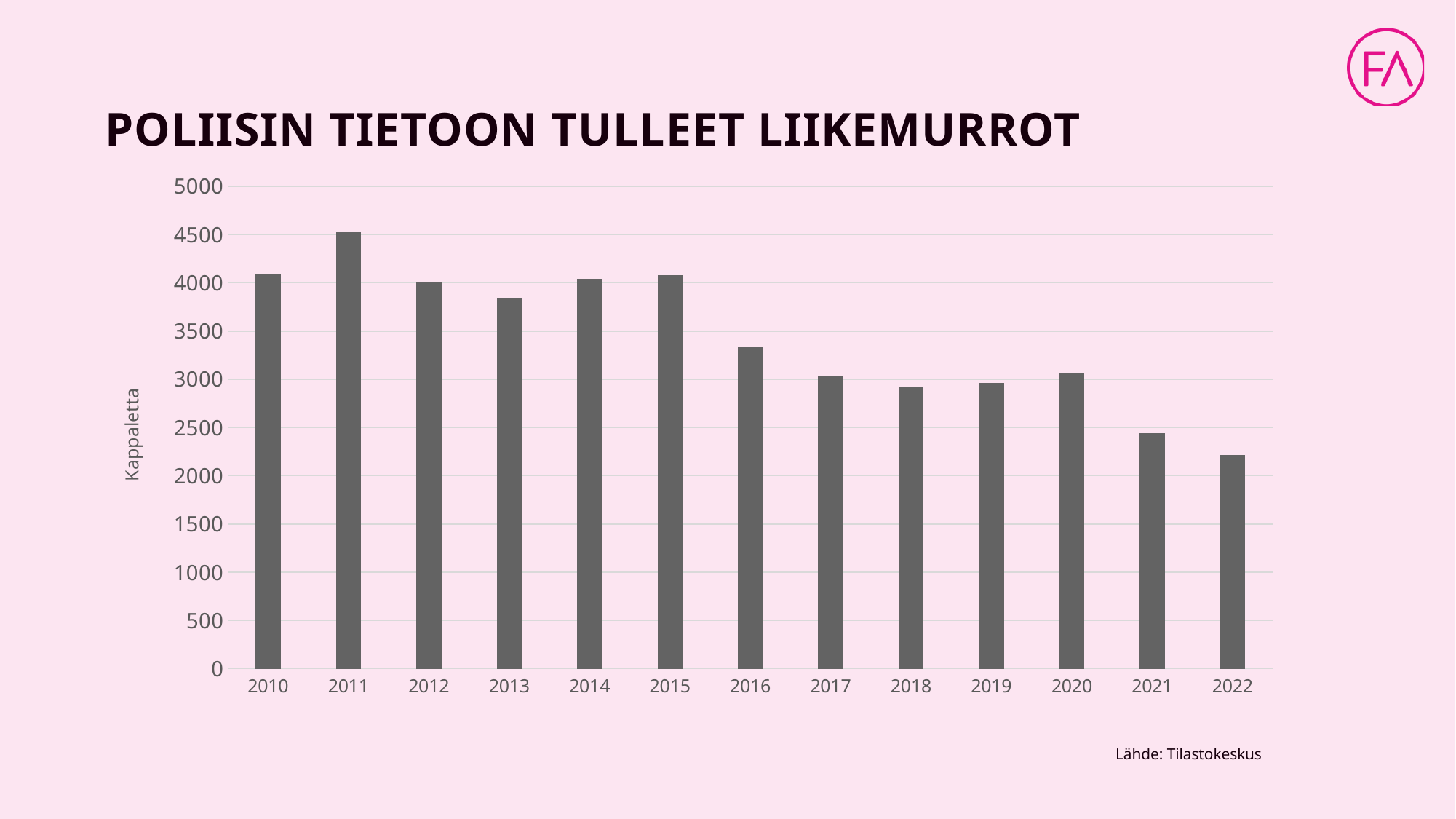
What kind of chart is shown on the slide? bar chart Is the value for 2021 greater or less than 2500? less Is the value for 2022 greater or less than 2500? less Which is larger, the value for 2011 or the value for 2022? 2011 Which is larger, the value for 2016 or the value for 2021? 2016 Which year has the lowest number of reported business burglaries? 2022 Which year has the highest number of reported business burglaries? 2011 Is the value for 2016 greater or less than 3000? greater What is the label on the vertical axis? Kappaletta Do the values generally rise or fall from 2010 to 2022? fall How many years are shown on the x axis? 13